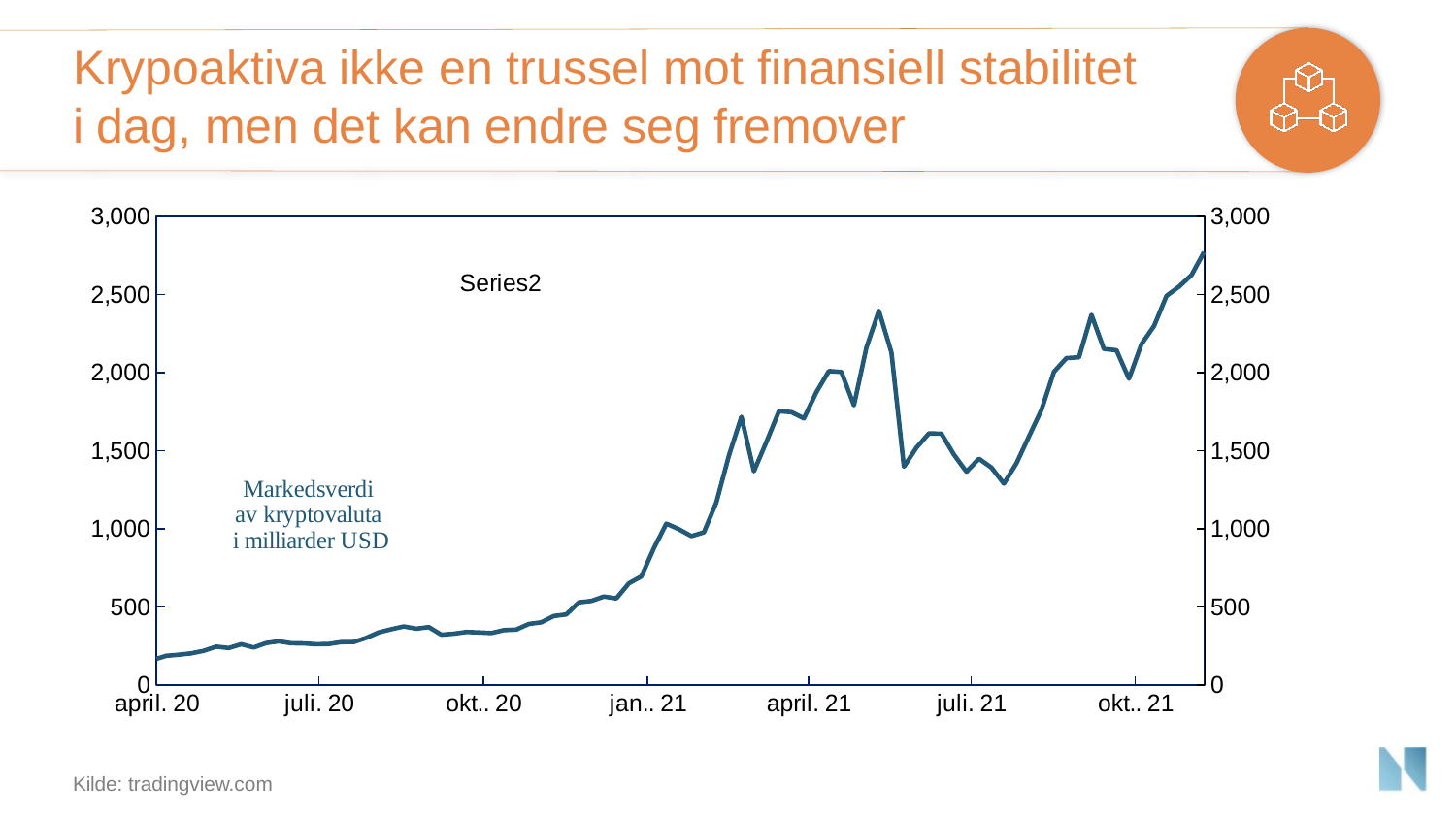
Is the value at juli 21 greater or less than 1,000? greater Is the value at april 20 greater or less than 500? less Is the highest point of the line greater or less than 2,500? greater What kind of chart is shown on the slide? line chart Which is larger, the value at jan 21 or the value at juli 21? juli 21 What source is cited for the chart? tradingview.com Does the market value of cryptocurrency rise or fall overall from april 20 to okt 21? rise Which is larger, the value at april 21 or the value at okt 21? okt 21 What does the text label inside the chart say the line represents? Markedsverdi av kryptovaluta i milliarder USD